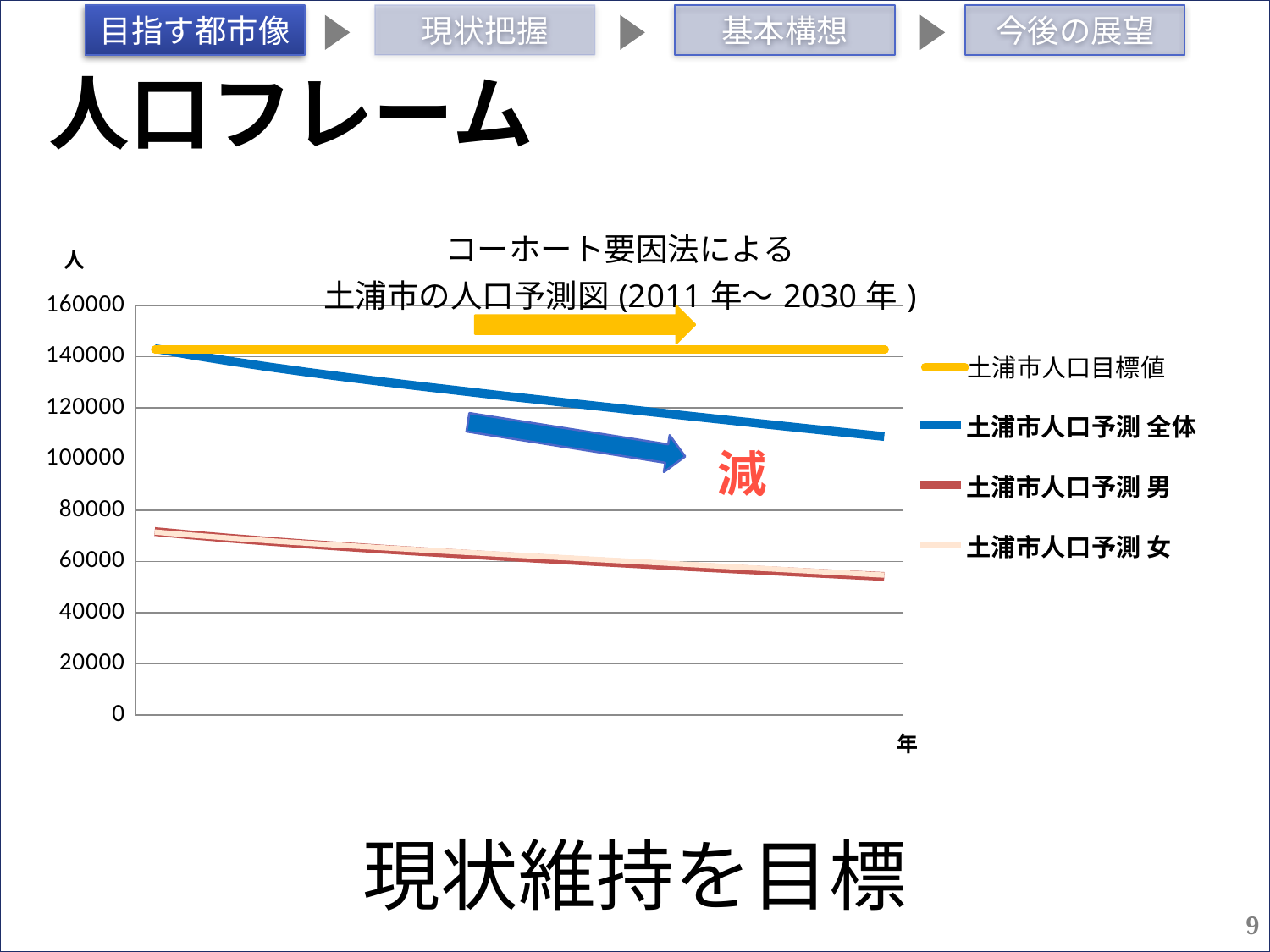
What kind of chart is shown on the slide? line chart What is the title of the chart? コーホート要因法による土浦市の人口予測図(2011年～2030年) Is the value of 土浦市人口予測 男 at the right end of the chart greater or less than 60000? less Does the 土浦市人口予測 全体 line rise or fall along the x axis? fall Is the value of 土浦市人口予測 全体 at the right end of the chart greater or less than 120000? less Is the value of 土浦市人口予測 全体 at the right end of the chart greater or less than 100000? greater Does the 土浦市人口目標値 line rise, fall, or stay flat along the x axis? stay flat Which series has the lowest values at the left end of the chart: 土浦市人口予測 全体 or 土浦市人口予測 男? 土浦市人口予測 男 How many series does the chart legend list? 4 At the right end of the chart, which is larger: 土浦市人口目標値 or 土浦市人口予測 全体? 土浦市人口目標値 Which series is drawn in yellow in the chart? 土浦市人口目標値